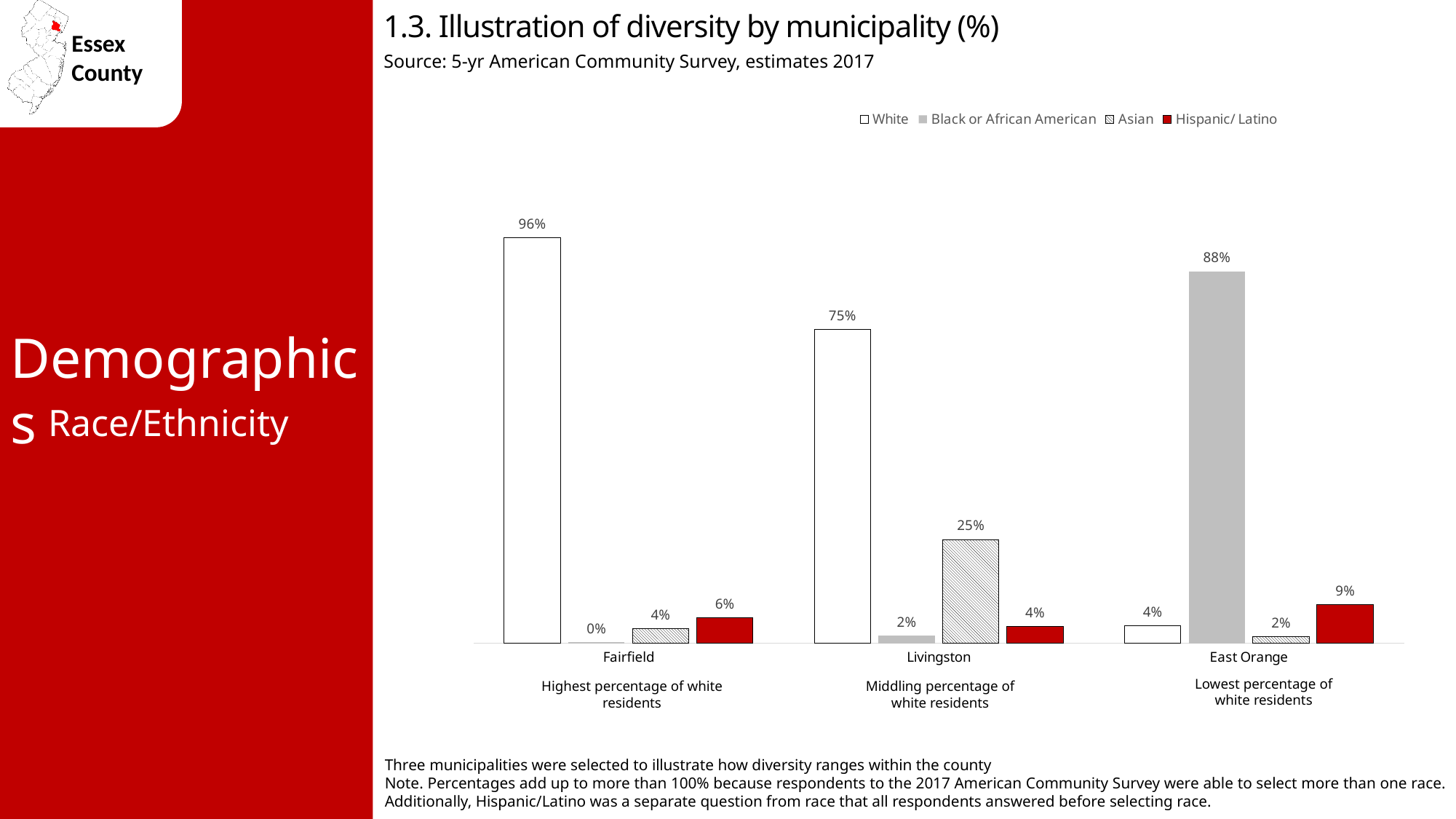
Which municipality has the lowest value for Black or African American? Fairfield What is the value for Asian in Livingston? 25% How many series does the legend list? 4 What is the value for Hispanic/ Latino in East Orange? 9% How many municipalities are shown on the x axis? 3 What is the difference between the White value in Fairfield and the White value in Livingston? 21% Which municipality has the highest value for White? Fairfield Which series is shown in red in the legend? Hispanic/ Latino What is the value for White in Fairfield? 96% Which is larger: the Asian value in Livingston or the Asian value in East Orange? Livingston What is the value for Black or African American in East Orange? 88% What kind of chart is shown on the slide? Bar chart